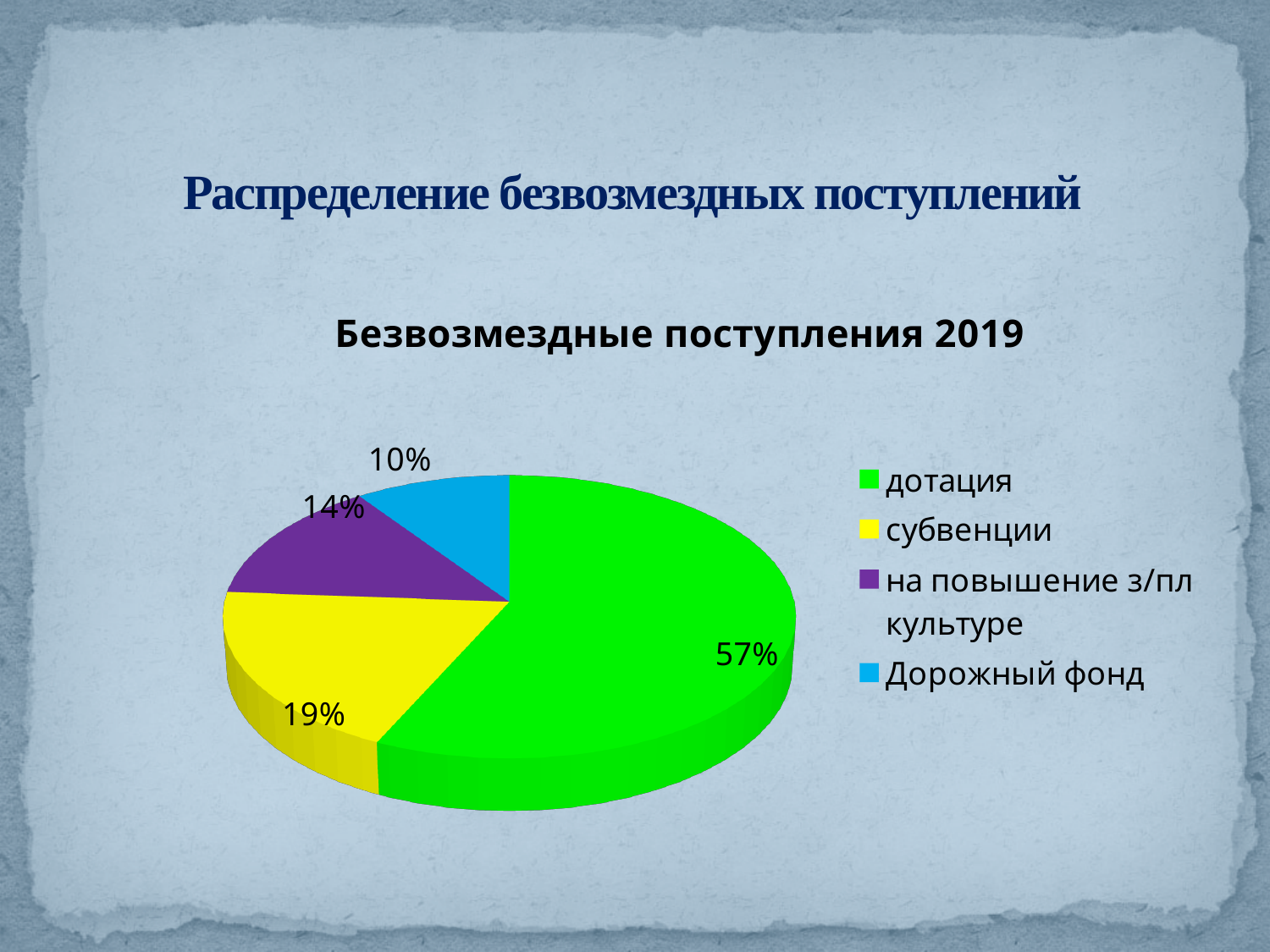
Which is larger, the share for субвенции or the share for Дорожный фонд? субвенции What is the difference in percentage points between дотация and субвенции? 38 What is the chart's title? Безвозмездные поступления 2019 What colour is the slice for на повышение з/пл культуре? purple What share of the pie does Дорожный фонд have? 10% What share of the pie does субвенции have? 19% What share of the pie does дотация have? 57% What kind of chart is shown on the slide? pie chart How many categories does the pie chart show? 4 Which category has the largest slice of the pie? дотация Which category has the smallest slice of the pie? Дорожный фонд